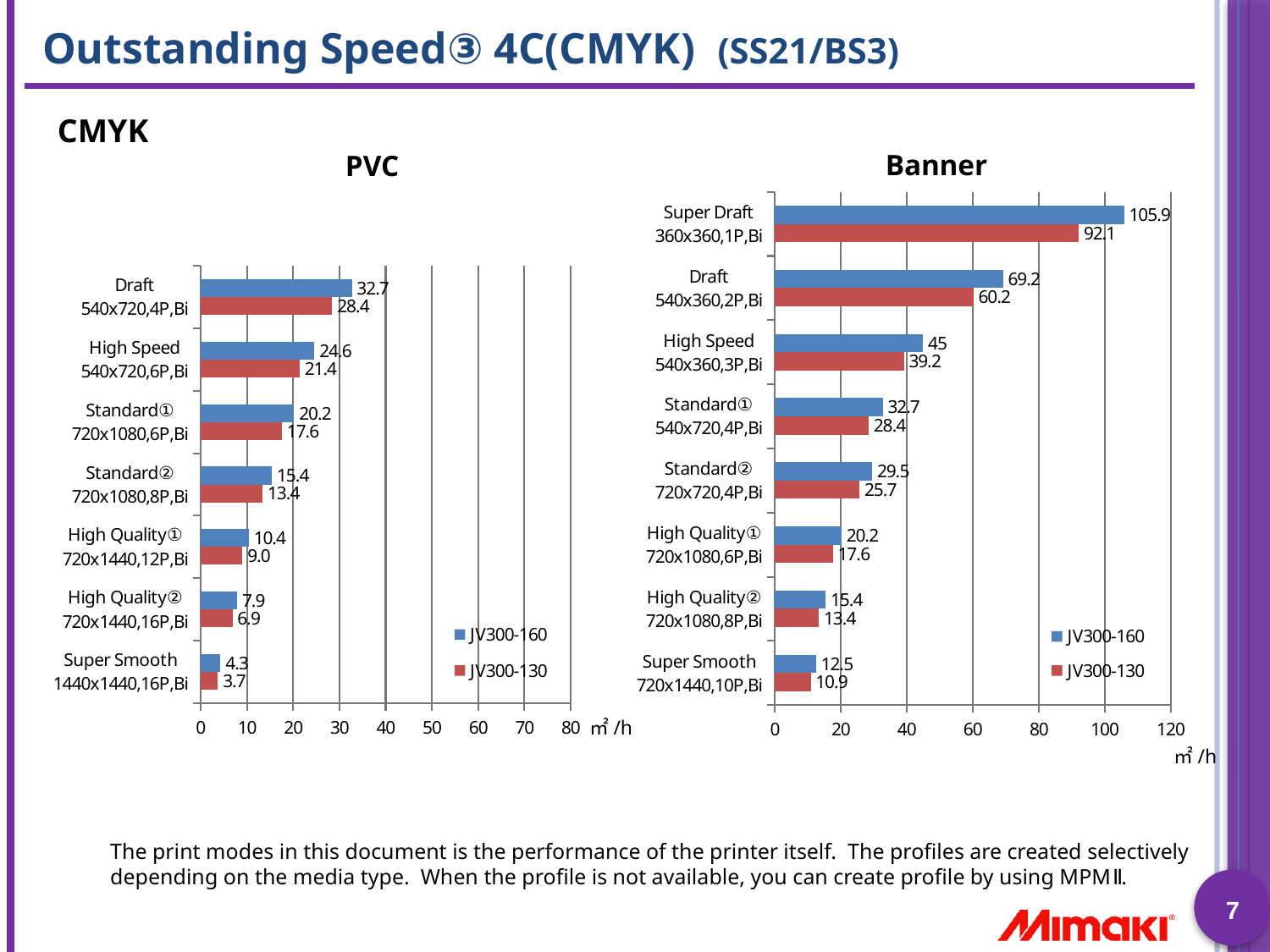
In the PVC chart, what is the difference between the JV300-160 and JV300-130 values for High Speed mode? 3.2 In the PVC chart, which print mode has the lowest JV300-130 value? Super Smooth In the PVC chart, what is the value for JV300-160 in Draft mode? 32.7 In the PVC chart, which colour represents the JV300-130 series? Red How many print modes are shown in the PVC chart? 7 What kind of chart is the PVC chart? Bar chart In the Banner chart, which is larger: the JV300-160 value for High Speed or the JV300-130 value for Draft? JV300-130 value for Draft In the Banner chart, is the JV300-160 value for Super Draft greater or less than 100? greater In the Banner chart, which print mode has the highest JV300-160 value? Super Draft In the Banner chart, what is the value for JV300-130 in Super Draft mode? 92.1 In the Banner chart, what is the difference between the JV300-160 and JV300-130 values for Draft mode? 9 How many series does the legend of the Banner chart list? 2